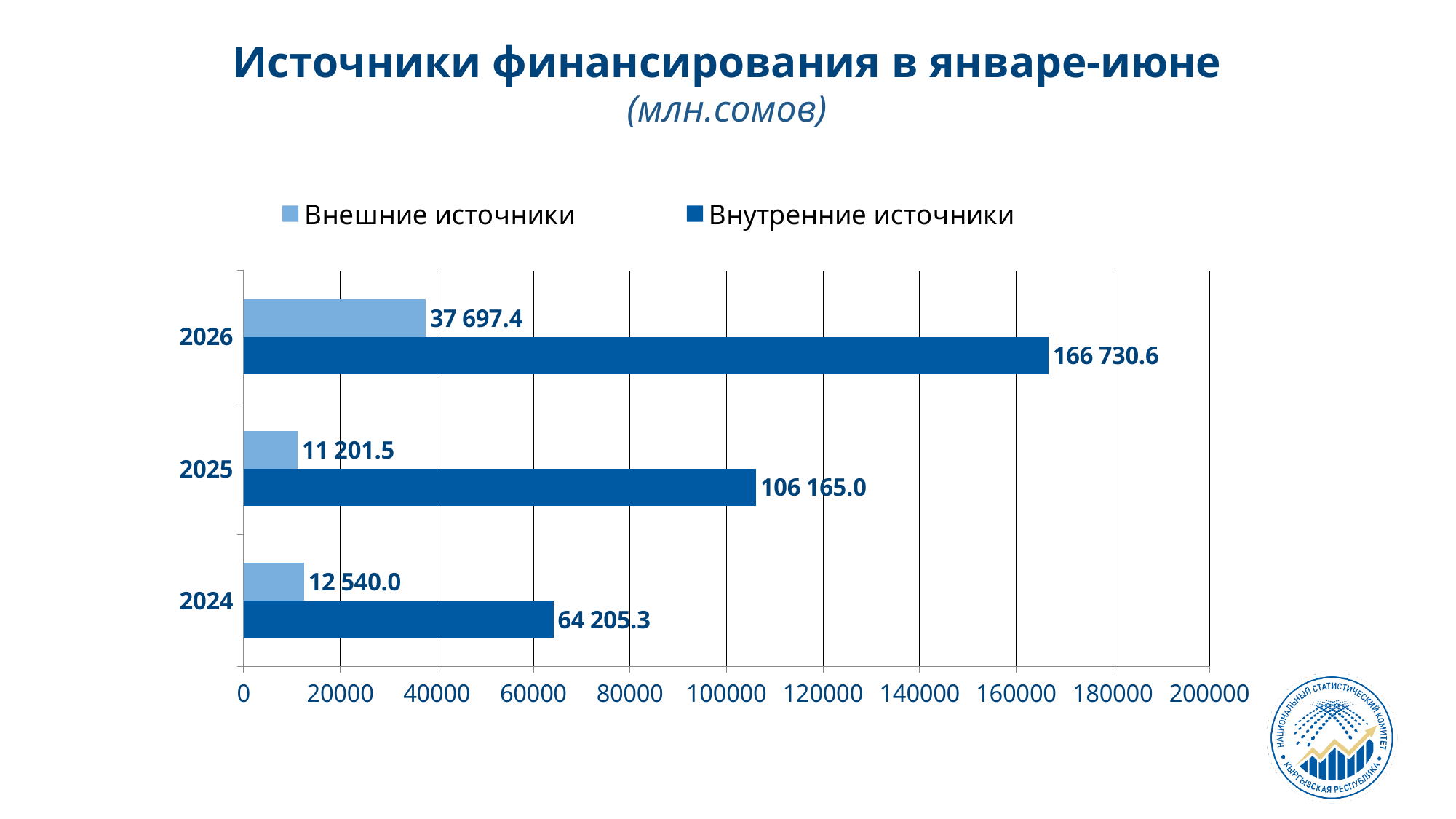
In which year is the value for Внешние источники the lowest? 2025 What is the difference between Внешние источники in 2024 and in 2025? 1 338.5 In which year is the value for Внутренние источники the highest? 2026 What is the value for Внутренние источники in 2026? 166 730.6 What is the value for Внешние источники in 2026? 37 697.4 What is the value for Внешние источники in 2025? 11 201.5 What is the value for Внутренние источники in 2024? 64 205.3 What kind of chart is shown on the slide? Bar chart What unit is given in the chart's subtitle? млн.сомов What is the difference between Внутренние источники in 2026 and in 2025? 60 565.6 How many series does the legend list? 2 Which is larger in 2024: Внешние источники or Внутренние источники? Внутренние источники